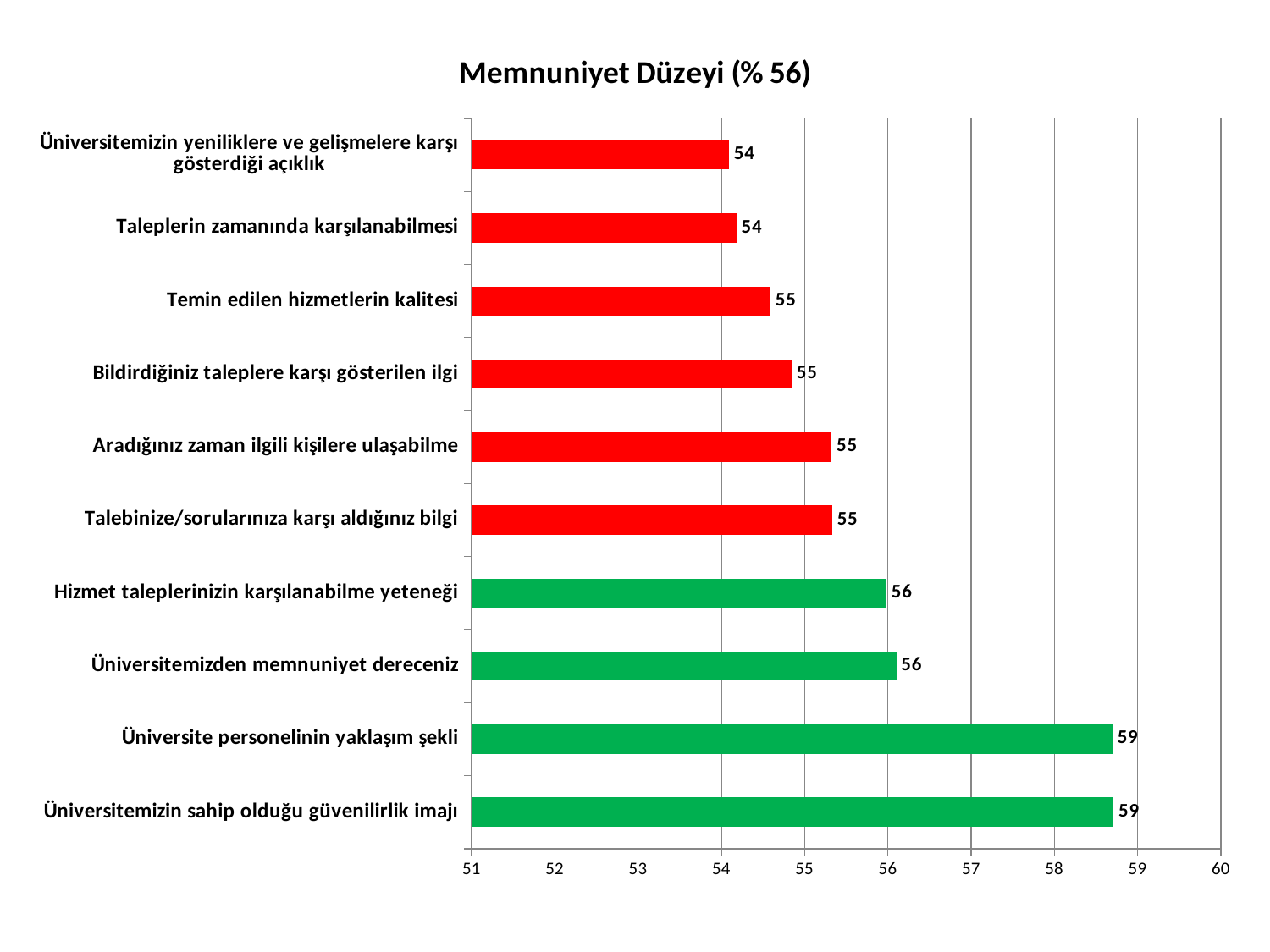
What is the difference between the values for "Üniversitemizin sahip olduğu güvenilirlik imajı" and "Üniversitemizin yeniliklere ve gelişmelere karşı gösterdiği açıklık"? 5 What is the value for "Hizmet taleplerinizin karşılanabilme yeteneği"? 56 What kind of chart is shown on the slide? bar chart What is the title of the chart? Memnuniyet Düzeyi (% 56) How many categories are shown in the chart? 10 What is the value for "Taleplerin zamanında karşılanabilmesi"? 54 Is the value for "Üniversitemizin sahip olduğu güvenilirlik imajı" greater or less than 58? greater What is the value for "Temin edilen hizmetlerin kalitesi"? 55 Which is larger: the value for "Üniversite personelinin yaklaşım şekli" or the value for "Aradığınız zaman ilgili kişilere ulaşabilme"? Üniversite personelinin yaklaşım şekli What colour are the bars for the four categories with the highest values? green Is the value for "Taleplerin zamanında karşılanabilmesi" greater or less than 55? less What is the value for "Üniversite personelinin yaklaşım şekli"? 59